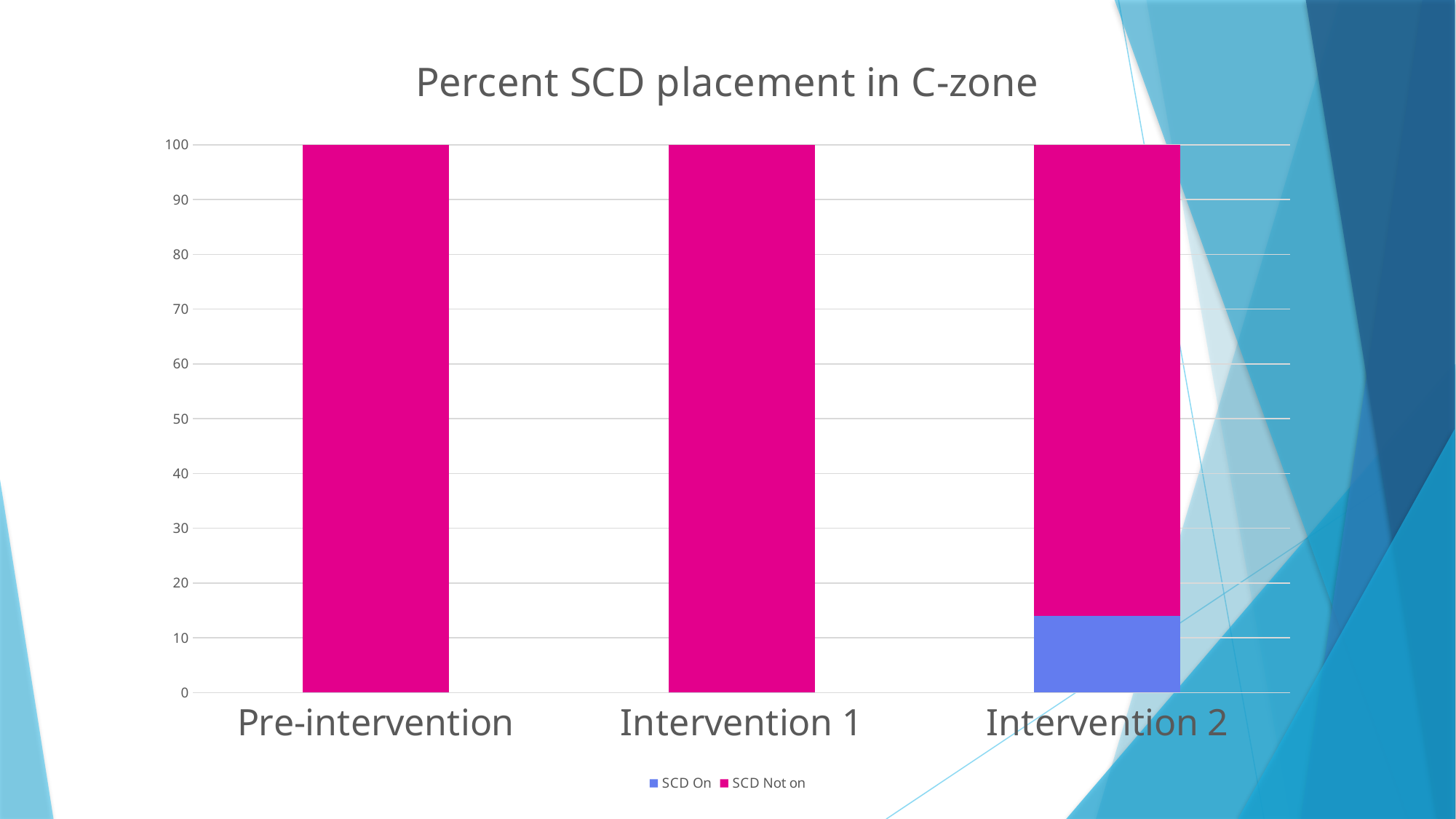
Is the value for SCD On in Intervention 2 greater or less than 10? greater What is the total height of the stacked bar for Pre-intervention? 100 How many categories are shown on the x axis of the chart? 3 Is the value for SCD Not on in Intervention 2 greater or less than 80? greater Which category has the highest value for SCD On? Intervention 2 Which category has the lowest value for SCD Not on? Intervention 2 How many series does the legend list? 2 Is the value for SCD On in Intervention 2 greater or less than 20? less Which series is shown in blue in the chart? SCD On What kind of chart is shown on the slide? Stacked bar chart Which is larger, the SCD Not on value for Intervention 1 or for Intervention 2? Intervention 1 What is the title of the chart? Percent SCD placement in C-zone